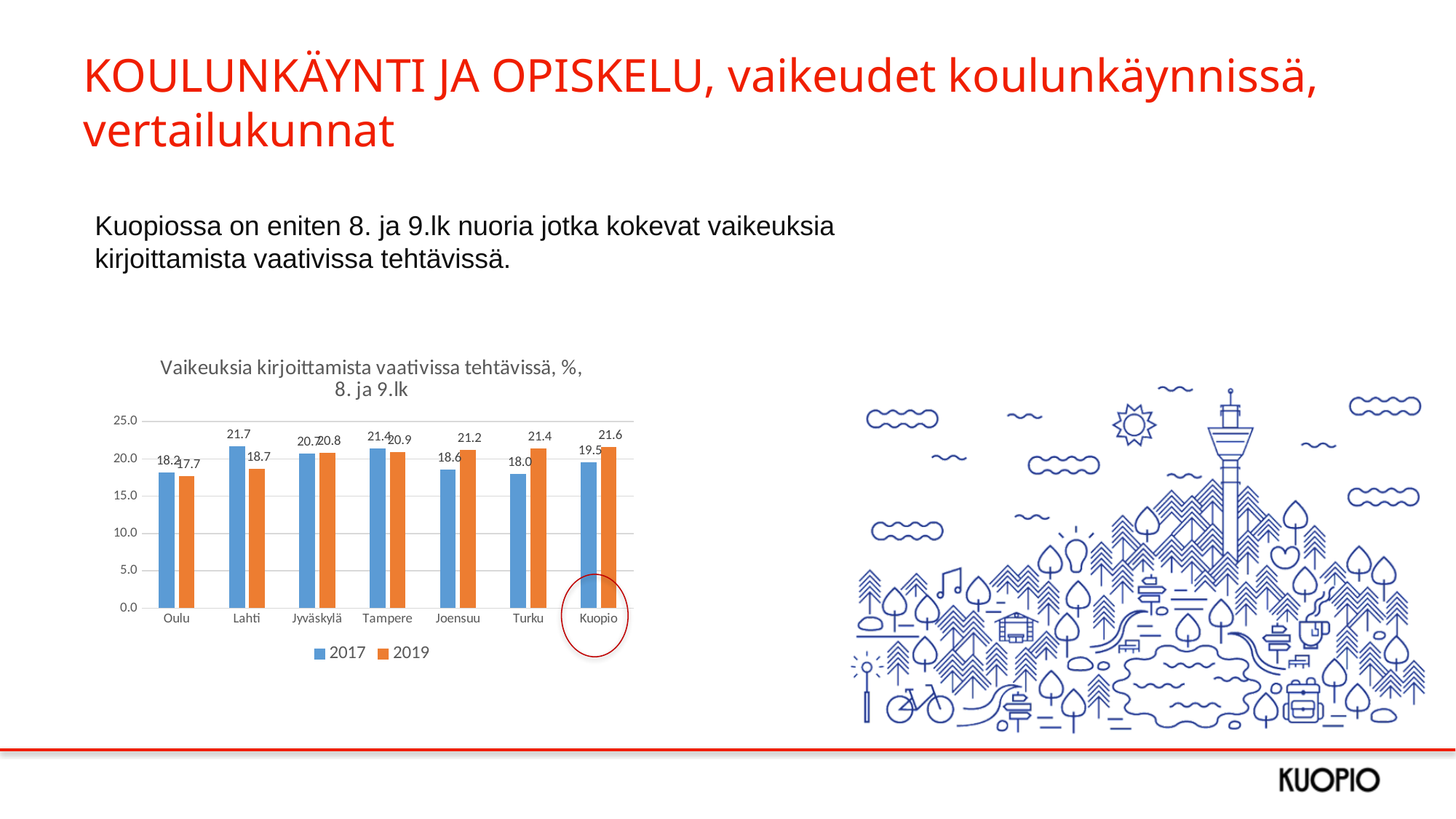
For Turku, which year has the larger value, 2017 or 2019? 2019 What is the difference between the 2019 and 2017 values for Kuopio? 2.1 What is the value for Kuopio in 2019? 21.6 What is the value for Oulu in 2019? 17.7 Which city has the highest value in 2019? Kuopio How many cities are shown on the x axis? 7 What is the difference between the 2017 and 2019 values for Lahti? 3.0 How many series does the legend list? 2 Which city has the lowest value in 2017? Turku Which city has the lowest value in 2019? Oulu What kind of chart is shown on the slide? Bar chart What is the value for Lahti in 2017? 21.7